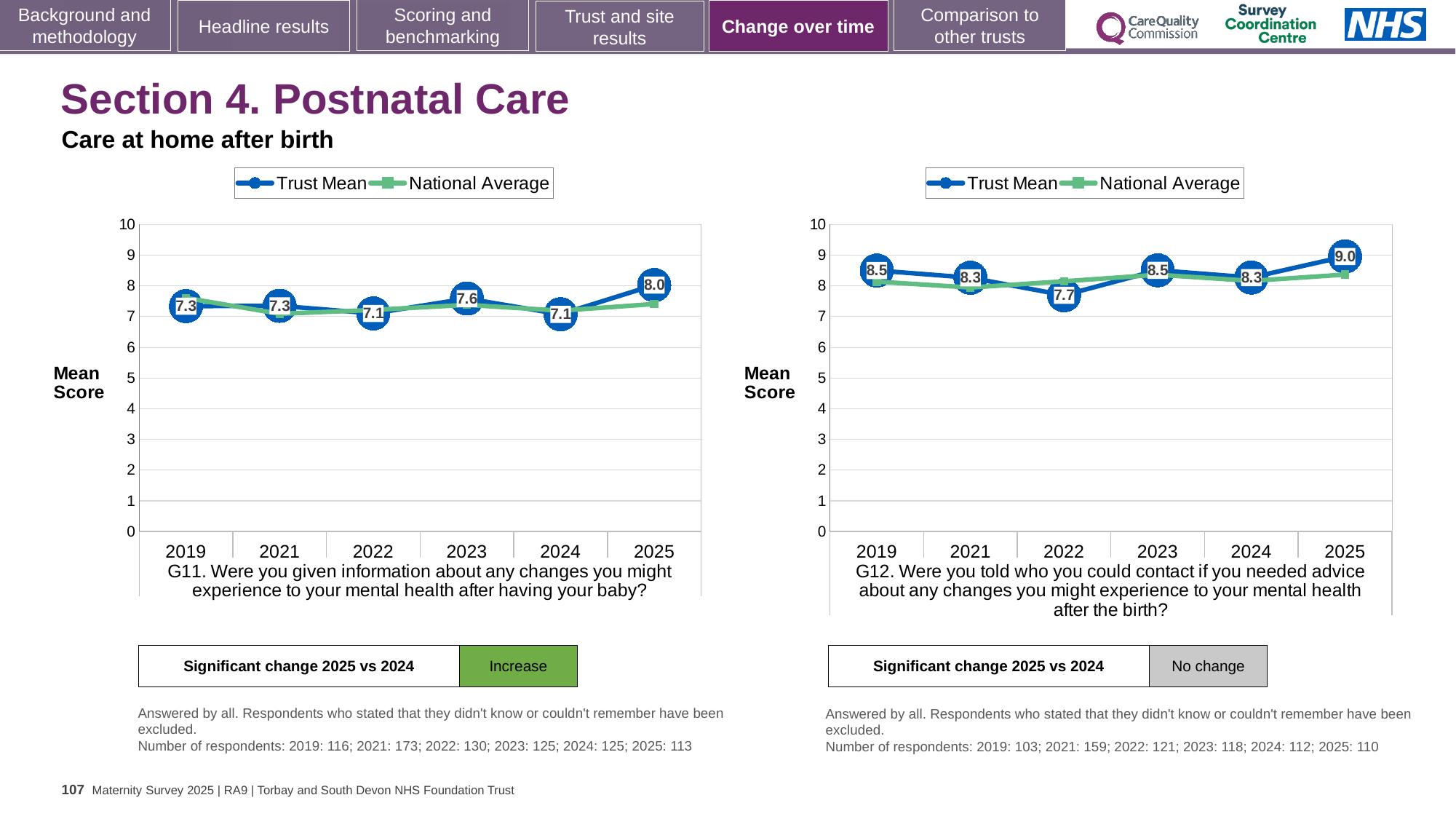
How many series does the legend of the G12 chart (right) list? 2 In the G12 chart (right), which year has the highest Trust Mean score? 2025 In the G11 chart (left), what is the Trust Mean score for 2023? 7.6 In the G11 chart (left), what is the Trust Mean score for 2025? 8.0 In the G12 chart (right), what is the difference between the Trust Mean scores for 2025 and 2022? 1.3 In the G12 chart (right), which year has the lowest Trust Mean score? 2022 In the G11 chart (left), which year has the highest Trust Mean score? 2025 How many years are plotted on the x axis of the G11 chart (left)? 6 What type of chart is the G11 chart (left)? Line chart In the G12 chart (right), is the Trust Mean score higher in 2019 or in 2021? 2019 In the G11 chart (left), what is the difference between the Trust Mean scores for 2025 and 2024? 0.9 In the G12 chart (right), what is the Trust Mean score for 2022? 7.7